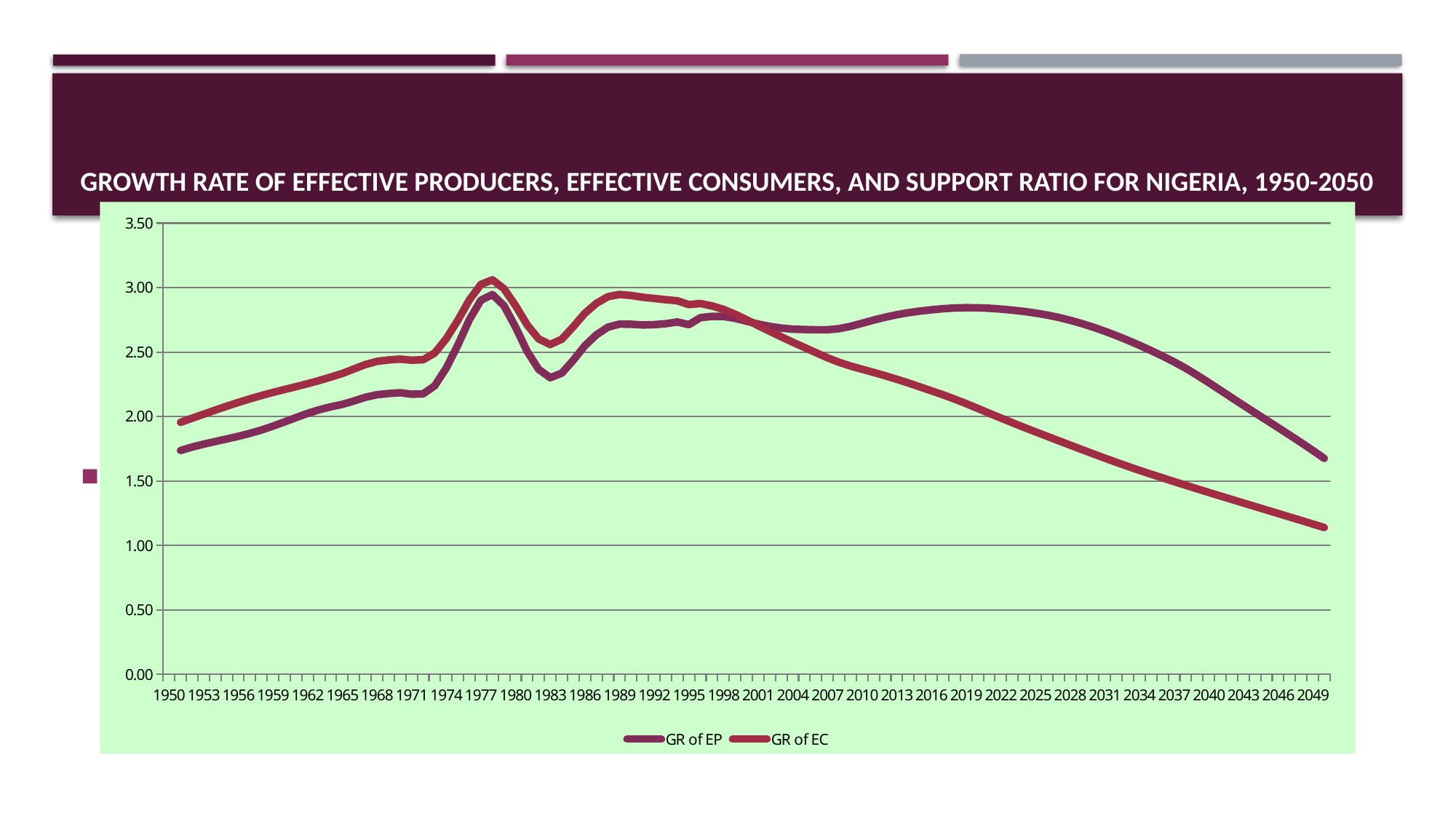
What is the highest value shown on the vertical axis? 3.50 Is the peak value of GR of EC around 1977 greater or less than 3.00? greater Is the value of GR of EC in 2049 greater or less than 1.50? less Is the value of GR of EP in 2049 greater or less than 1.50? greater In 1950, which series has the higher value, GR of EP or GR of EC? GR of EC What kind of chart is shown on the slide? Line chart In 2049, which series has the higher value, GR of EP or GR of EC? GR of EP What are the two series named in the legend? GR of EP and GR of EC How many series does the legend list? 2 Does the GR of EC line rise or fall between 2001 and 2049? Fall